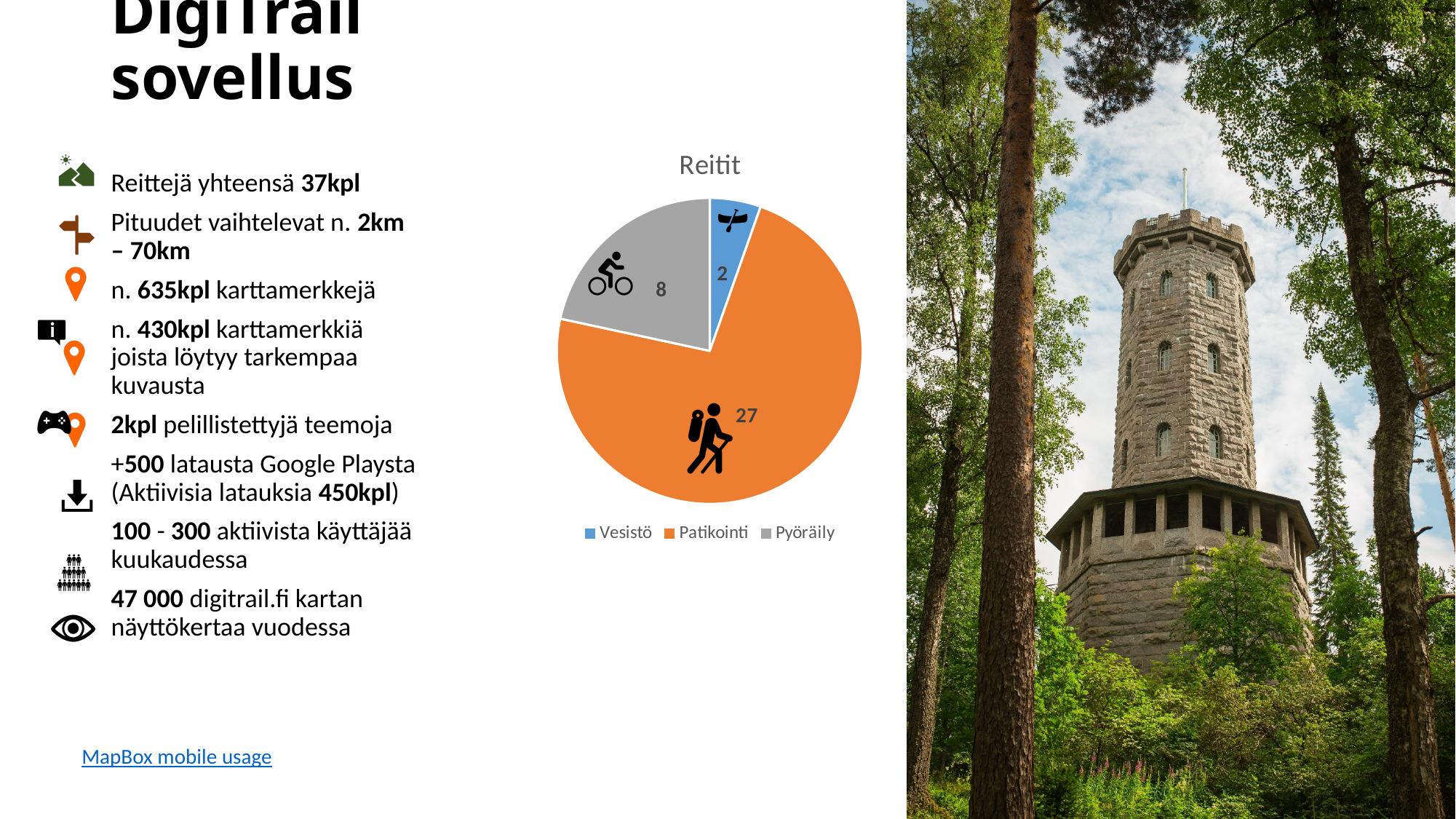
What is the total of all slices in the Reitit pie chart? 37 Which category has the smallest slice in the Reitit pie chart? Vesistö What is the difference between the Patikointi and Pyöräily values in the Reitit chart? 19 What is the value for Vesistö in the Reitit pie chart? 2 Which category has the largest slice in the Reitit pie chart? Patikointi How many categories does the Reitit pie chart show? 3 What is the difference between the Pyöräily and Vesistö values in the Reitit chart? 6 What is the title of the pie chart on the slide? Reitit What is the value for Pyöräily in the Reitit pie chart? 8 What kind of chart is the Reitit chart? Pie chart Which is larger in the Reitit chart, Pyöräily or Vesistö? Pyöräily What is the value for Patikointi in the Reitit pie chart? 27